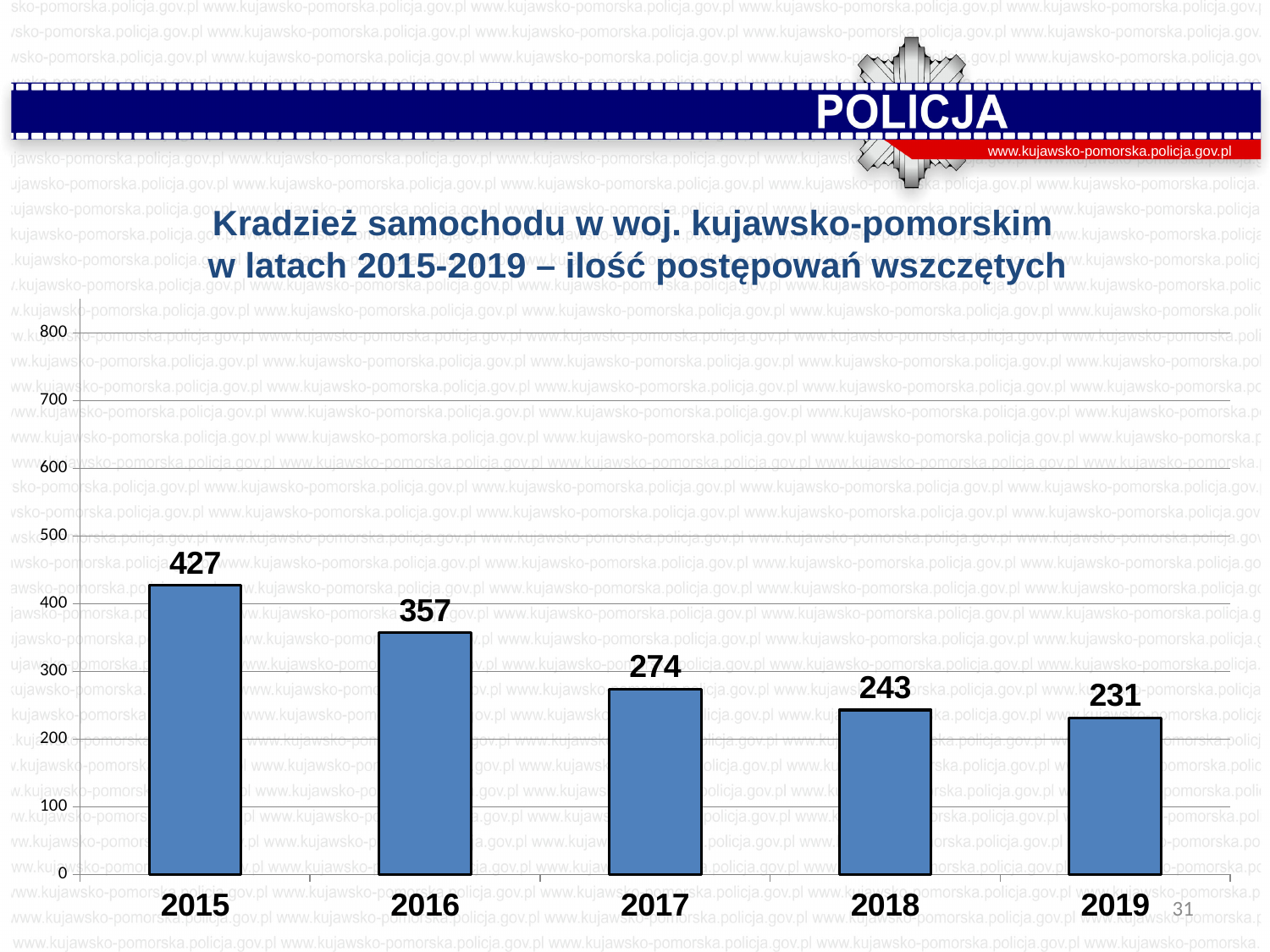
What is the value for 2015? 427 What is the difference between the values for 2018 and 2019? 12 What is the value for 2019? 231 How many years are shown on the x axis? 5 Which year has the lowest value? 2019 Which is larger, the value for 2016 or the value for 2017? 2016 What is the difference between the values for 2015 and 2016? 70 What kind of chart is shown on the slide? bar chart Is the value for 2018 greater or less than 300? less What is the value for 2017? 274 Do the values rise or fall from 2015 to 2019? fall Which year has the highest value? 2015